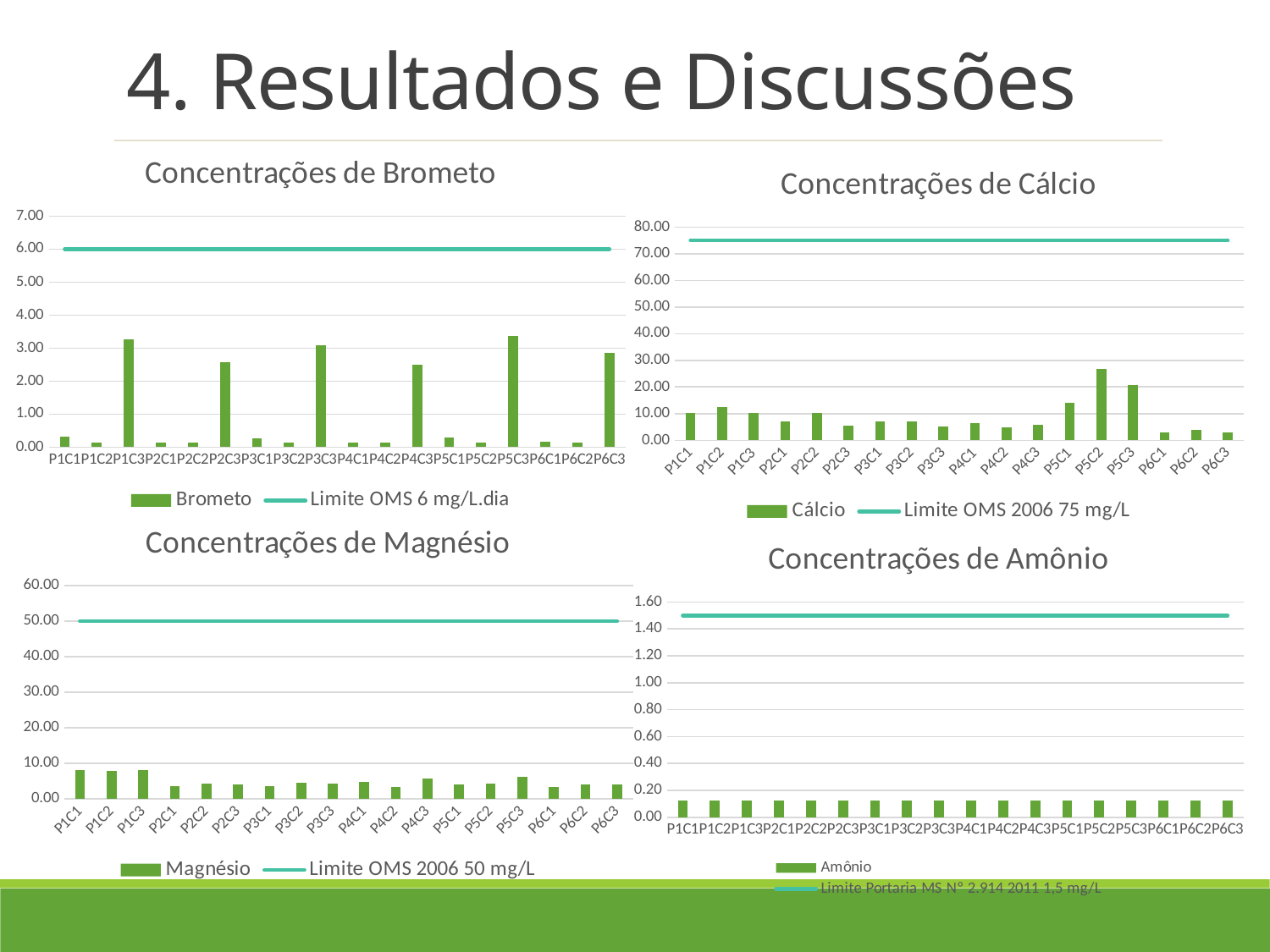
How many categories are shown on the x axis of the 'Concentrações de Magnésio' chart? 18 In the 'Concentrações de Brometo' chart, is the value for P2C3 greater or less than 3.00? less In the 'Concentrações de Brometo' chart, what is the legend label of the horizontal line series? Limite OMS 6 mg/L.dia What kind of chart is the 'Concentrações de Brometo' chart? bar chart In the 'Concentrações de Cálcio' chart, which is larger, the value for P5C2 or the value for P6C1? P5C2 How many series does the legend of the 'Concentrações de Cálcio' chart list? 2 In the 'Concentrações de Cálcio' chart, which category has the highest value? P5C2 In the 'Concentrações de Brometo' chart, is the value for P1C3 greater or less than 3.00? greater In the 'Concentrações de Brometo' chart, which is larger, the value for P1C3 or the value for P1C2? P1C3 In the 'Concentrações de Amônio' chart, is the value for P1C1 greater or less than 0.20? less